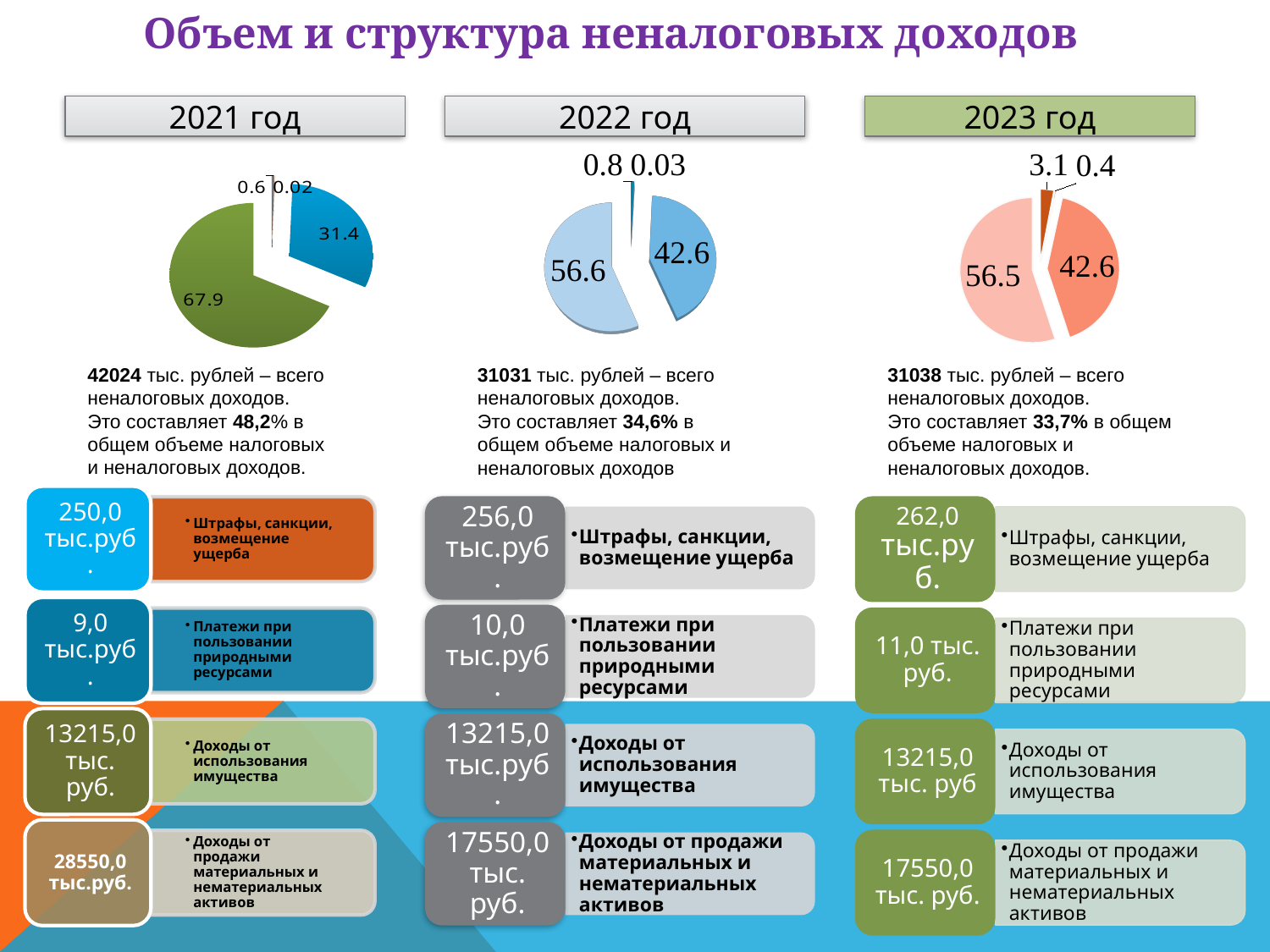
In the 2022 год pie chart, what is the difference between the slices labelled 56.6 and 42.6? 14.0 In the 2022 год pie chart, what is the value of the smallest slice? 0.03 In the 2021 год pie chart, what is the value of the largest slice? 67.9 In the 2021 год pie chart, what is the value of the smallest slice? 0.02 In the 2023 год pie chart, what is the difference between the slices labelled 56.5 and 42.6? 13.9 How many pie charts are shown on the slide? 3 How many slices does the 2022 год pie chart have? 4 In the 2021 год pie chart, what is the difference between the two largest slices (67.9 and 31.4)? 36.5 In the 2023 год pie chart, what is the value of the largest slice? 56.5 In the 2023 год pie chart, which is larger: the slice labelled 3.1 or the slice labelled 0.4? 3.1 In the 2022 год pie chart, what is the value of the largest slice? 56.6 What kind of chart is shown under the "2021 год" heading? pie chart